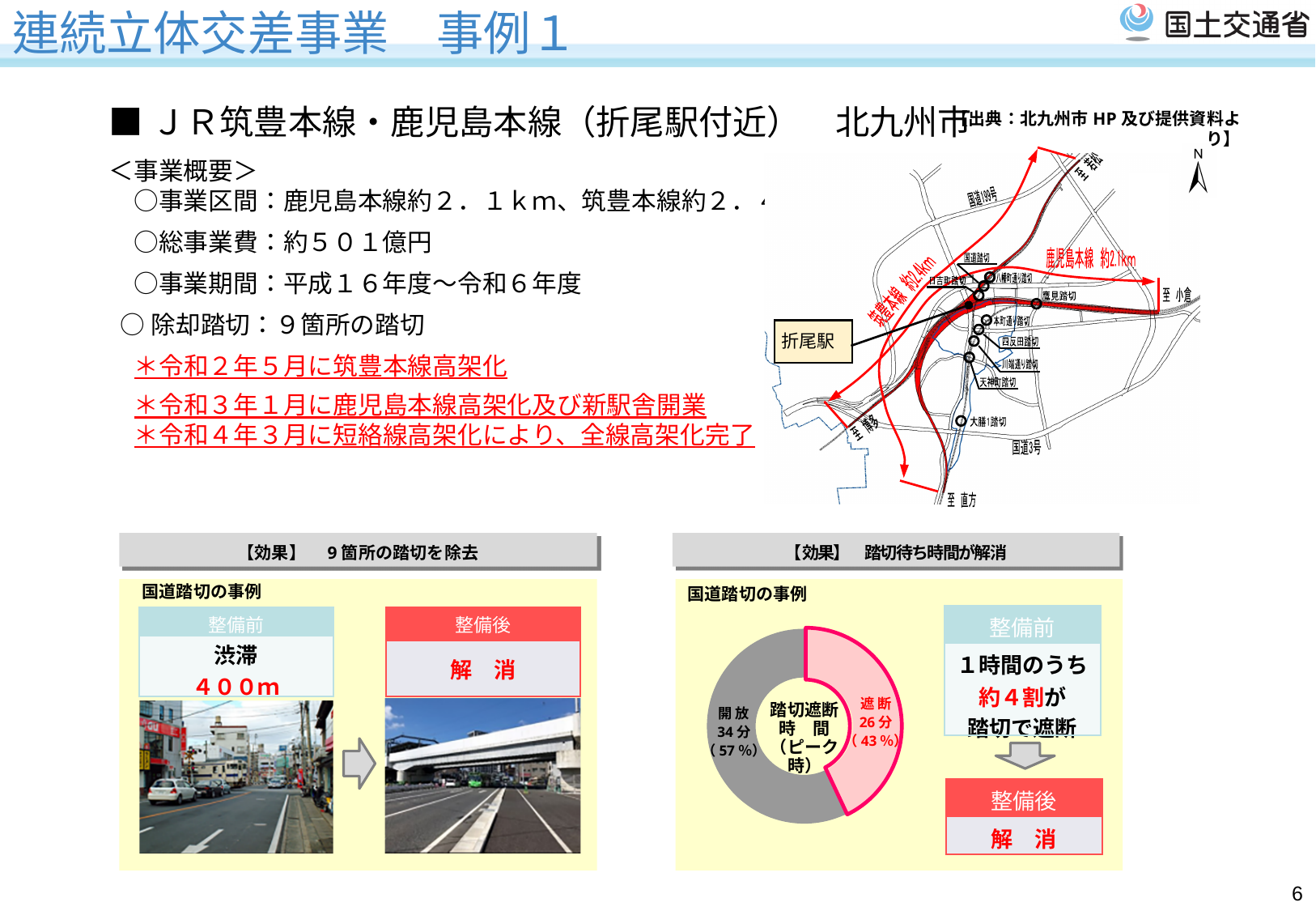
In the donut chart, what is the total of 遮断 and 開放 in minutes? 60分 In the donut chart, what percentage share does the 遮断 slice represent? 43% How many slices does the donut chart have? 2 What kind of chart is shown in the 踏切待ち時間が解消 panel at the bottom right of the slide? Donut (pie) chart In the donut chart, which category has the largest value? 開放 In the donut chart, which slice is larger, 遮断 or 開放? 開放 In the donut chart, what percentage share does the 開放 slice represent? 57% In the donut chart, what is the value shown for 開放? 34分（57%） In the donut chart, which category has the smallest value? 遮断 In the donut chart, what is the value shown for 遮断? 26分（43%） In the donut chart, how many minutes longer is 開放 than 遮断? 8分 What label is written in the centre of the donut chart? 踏切遮断時間（ピーク時）